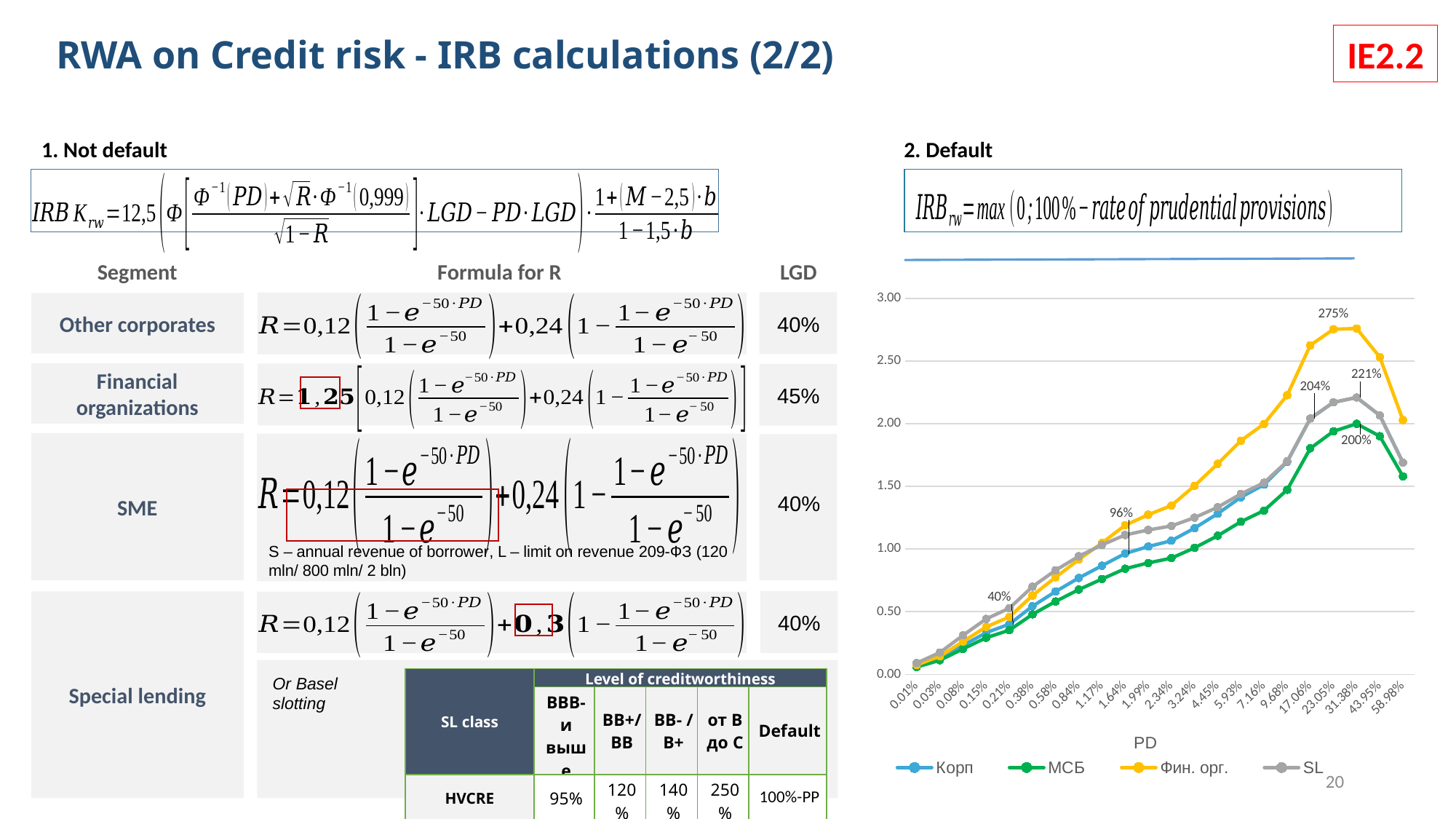
Is the value for МСБ at PD 0.01% greater or less than 0.50? less How many series does the legend of the line chart list? 4 What is the data label at the peak of the Фин. орг. line? 275% Is the value for Фин. орг. at PD 23.05% greater or less than 2.50? greater Do the values for Фин. орг. rise or fall from PD 0.01% to PD 23.05%? rise Which series reaches the highest peak on the line chart? Фин. орг. At PD 58.98%, which series has the larger value, Фин. орг. or МСБ? Фин. орг. What are the legend entries of the line chart? Корп, МСБ, Фин. орг., SL What is the data label at the peak of the SL line? 221% What kind of chart is shown on the right side of the slide under '2. Default'? line chart What is the data label at the peak of the МСБ line? 200% What is the x-axis title of the line chart? PD